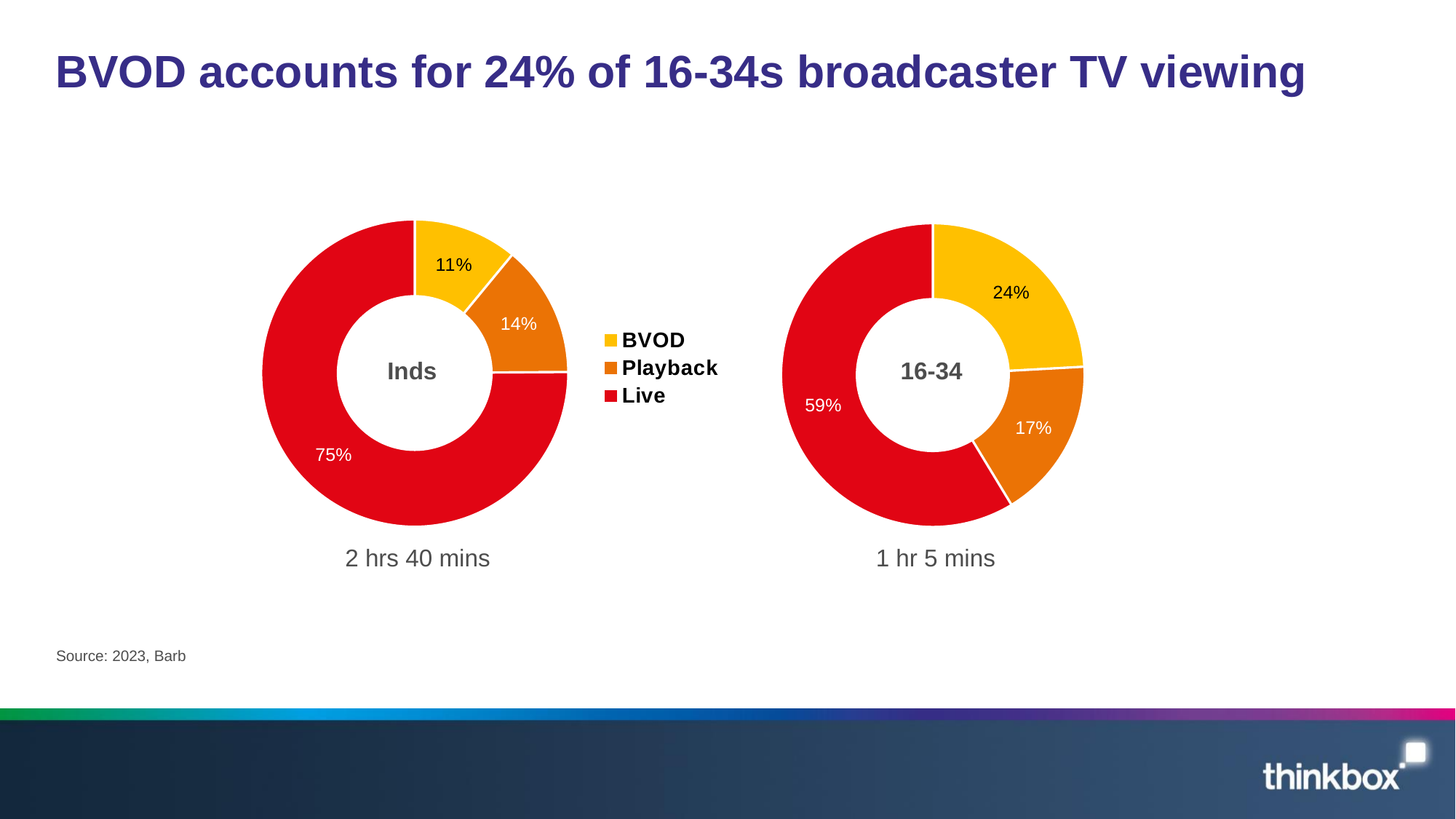
What type of chart is used on this slide? Donut (pie) chart What is the difference between the Live share in the Inds chart and the Live share in the 16-34 chart? 16 percentage points Is the BVOD share larger in the Inds chart or the 16-34 chart? 16-34 In the Inds donut chart, what share of viewing is BVOD? 11% In the Inds donut chart, which category has the largest share? Live In the 16-34 donut chart, what share of viewing is Playback? 17% How many categories does each donut chart show? 3 How many entries does the legend list? 3 In the 16-34 donut chart, which category has the smallest share? Playback What total viewing time is shown beneath the 16-34 donut chart? 1 hr 5 mins In the 16-34 donut chart, what share of viewing is Live? 59% In the Inds donut chart, which category has the smallest share? BVOD